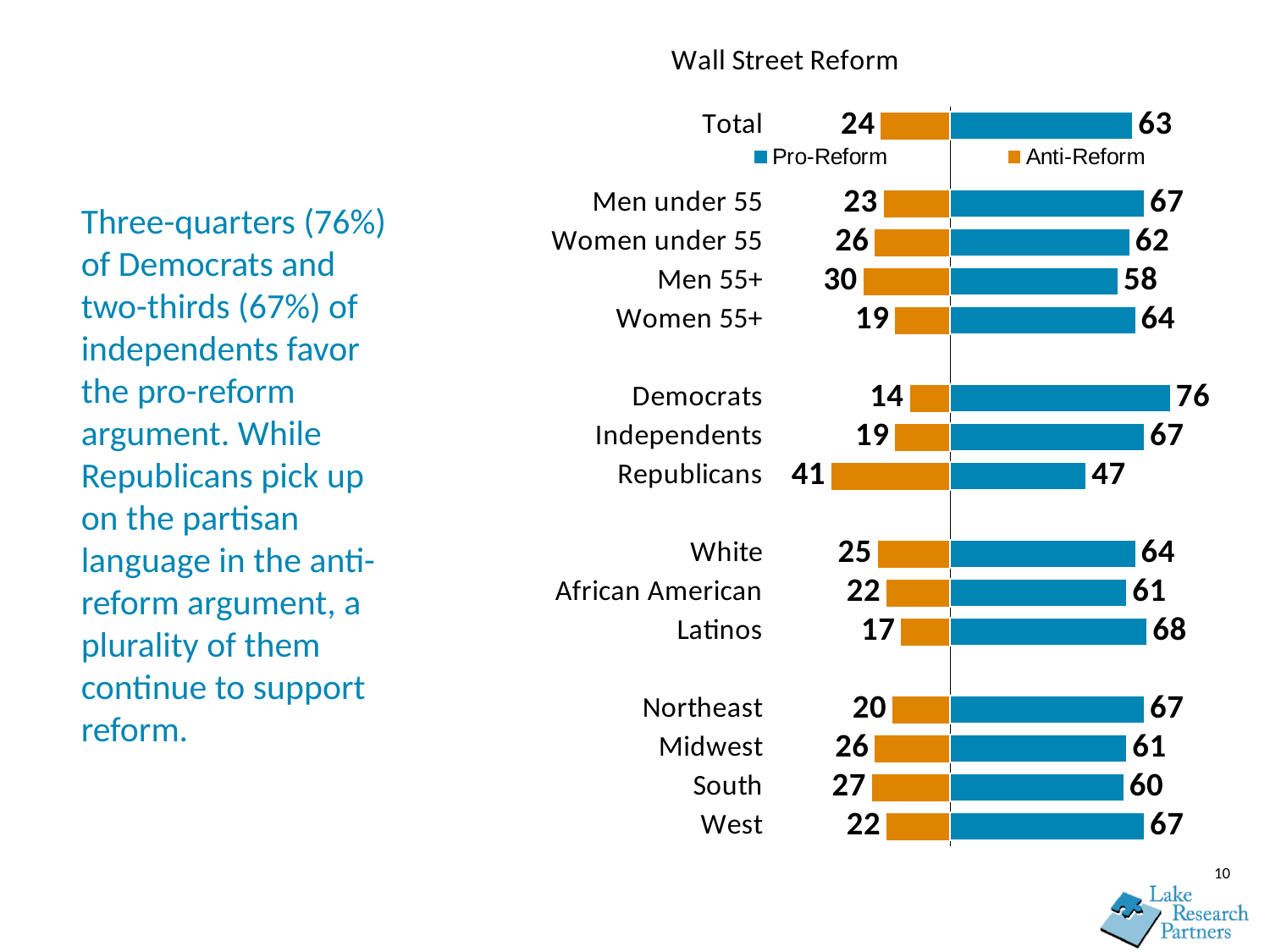
Which category has the highest Pro-Reform value? Democrats Which has a higher Pro-Reform value, Men 55+ or Women 55+? Women 55+ What is the Pro-Reform value for Total? 63 What kind of chart is shown on the slide? Bar chart How many series does the legend list? 2 What is the title of the chart? Wall Street Reform Which category has the lowest Anti-Reform value? Democrats How many categories are shown in the chart? 15 What is the Pro-Reform value for Democrats? 76 What is the difference between the Pro-Reform and Anti-Reform values for Republicans? 6 What is the Anti-Reform value for Republicans? 41 What is the Anti-Reform value for Latinos? 17